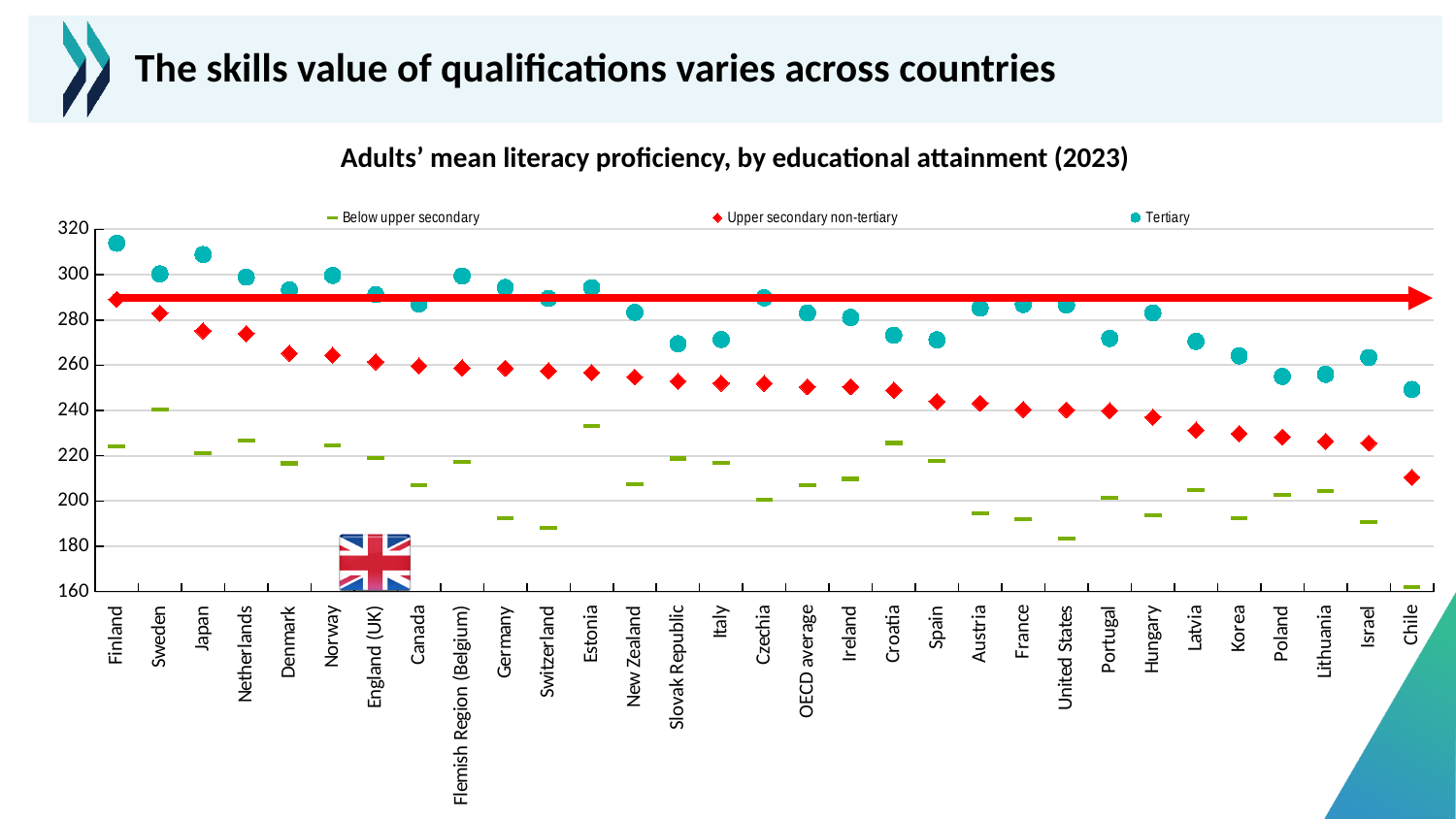
How many countries or regions are shown on the x axis? 31 Do the Tertiary values generally rise or fall from left to right along the x axis? fall Which country has the lowest Tertiary value? Chile Which is larger, the Upper secondary non-tertiary value for Sweden or for Japan? Sweden Is the Tertiary value for Finland greater or less than 300? greater How many series does the legend list? 3 Which country has the highest Tertiary value? Finland Is the Below upper secondary value for the United States greater or less than 200? less Is the Below upper secondary value for Chile greater or less than 180? less Which country has the highest Below upper secondary value? Sweden Which country has the lowest Below upper secondary value? Chile What is the title of the chart? Adults' mean literacy proficiency, by educational attainment (2023)